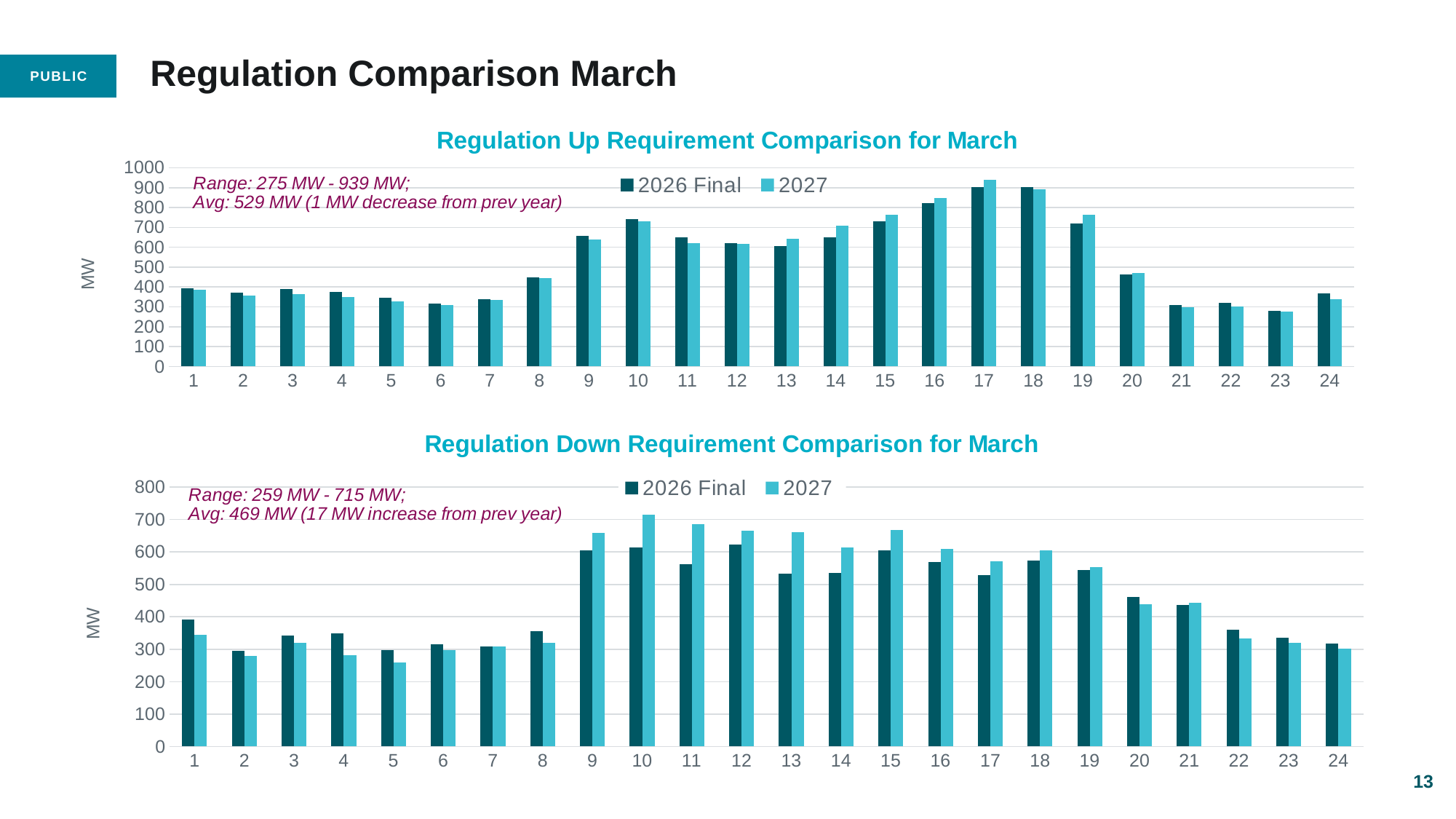
In the Regulation Down Requirement Comparison for March chart, which series has the larger value at hour 1, 2026 Final or 2027? 2026 Final In the Regulation Down Requirement Comparison for March chart, which series has the larger value at hour 11, 2026 Final or 2027? 2027 In the Regulation Up Requirement Comparison for March chart, is the 2027 value for hour 17 greater or less than 900? greater In the Regulation Down Requirement Comparison for March chart, is the 2027 value for hour 5 greater or less than 300? less In the Regulation Down Requirement Comparison for March chart, at which hour is the 2027 value highest? 10 In the Regulation Up Requirement Comparison for March chart, is the 2026 Final value for hour 10 greater or less than 700? greater What kind of chart is the Regulation Up Requirement Comparison for March? bar chart What is the y-axis label on the Regulation Up Requirement Comparison for March chart? MW How many series does the legend list in the Regulation Down Requirement Comparison for March chart? 2 In the Regulation Up Requirement Comparison for March chart, at which hour is the 2027 value highest? 17 How many hour categories are shown on the x axis of the Regulation Up Requirement Comparison for March chart? 24